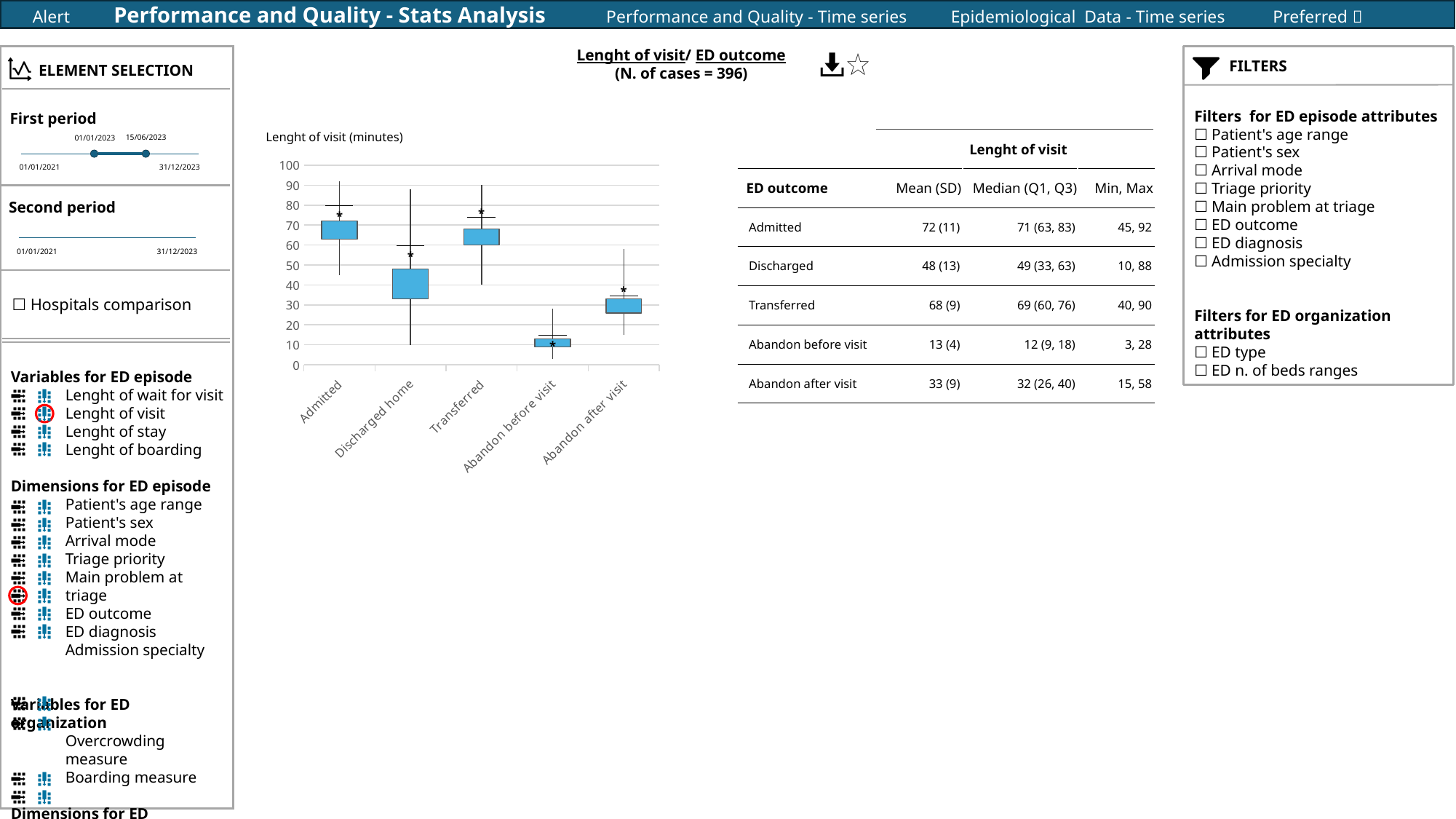
According to the table next to the chart, what is the Mean (SD) length of visit for Admitted? 72 (11) What is the number of cases stated in the chart title? 396 According to the table next to the chart, what is the Median (Q1, Q3) length of visit for Abandon before visit? 12 (9, 18) What kind of chart is shown under the title 'Lenght of visit/ ED outcome'? box plot According to the table next to the chart, what is the difference between the mean length of visit for Admitted and for Abandon before visit? 59 In the box plot, is the box for 'Admitted' greater or less than 60 minutes? greater How many ED outcome categories are plotted on the x axis of the box plot? 5 Which ED outcome category has the lowest box in the box plot? Abandon before visit In the box plot, is the box for 'Abandon before visit' above or below 20 minutes? below What is the label of the y axis of the box plot? Lenght of visit (minutes) Which has a higher box in the box plot: 'Transferred' or 'Abandon after visit'? Transferred